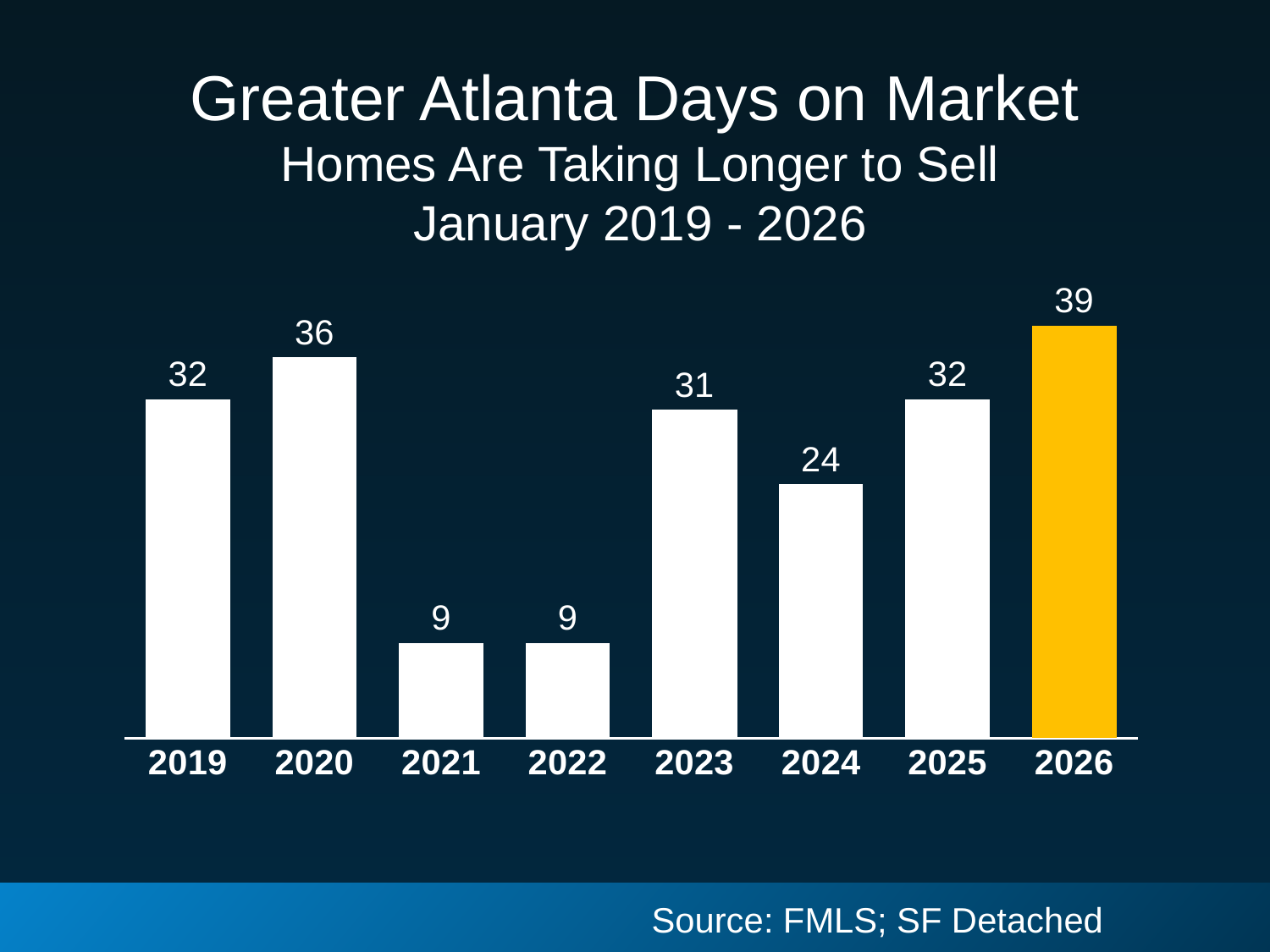
Which year has the highest days on market? 2026 Do the days on market values rise or fall from 2022 to 2026? Rise What is the difference in days on market between 2020 and 2021? 27 What is the days on market value for 2026? 39 What is the days on market value for 2024? 24 What is the difference in days on market between 2026 and 2025? 7 Which year has a larger days on market value, 2023 or 2024? 2023 Which bar is coloured differently from the others? 2026 What kind of chart is shown on the slide? Bar chart Which years have the lowest days on market? 2021 and 2022 How many years are shown on the chart? 8 What is the days on market value for 2020? 36